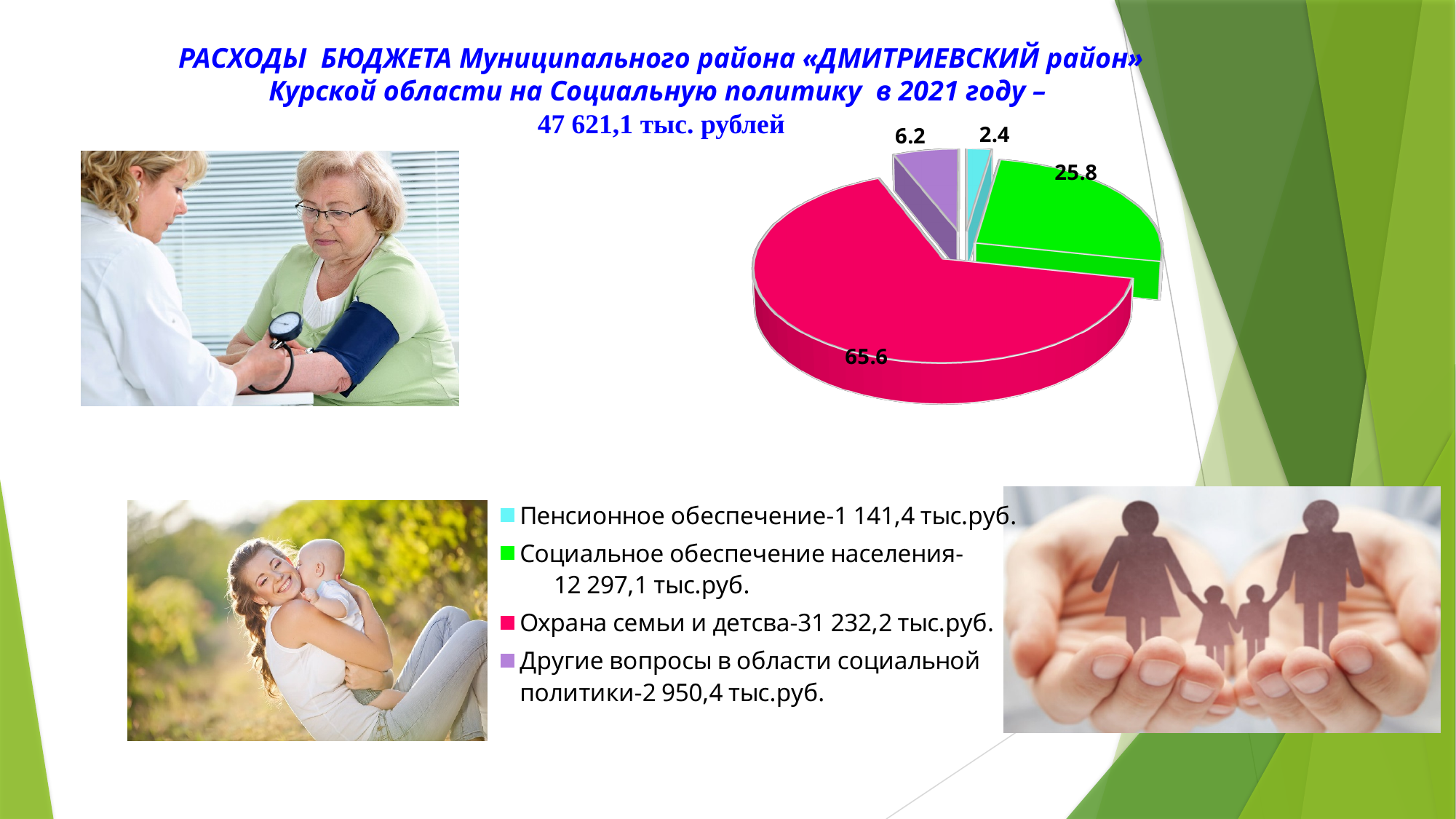
What share of the pie does the slice for Социальное обеспечение населения have? 25.8 What kind of chart is shown on the slide? pie chart What is the difference between the shares for Охрана семьи и детства and Социальное обеспечение населения? 39.8 What share of the pie does the slice for Пенсионное обеспечение have? 2.4 What share of the pie does the slice for Охрана семьи и детства have? 65.6 Which category has the largest slice of the pie? Охрана семьи и детства Which category has the smallest slice of the pie? Пенсионное обеспечение What colour is the slice for Социальное обеспечение населения? green What total amount in thousand rubles is stated in the slide title? 47 621,1 тыс. рублей How many slices does the pie chart have? 4 Which is larger: the slice for Другие вопросы в области социальной политики or the slice for Пенсионное обеспечение? Другие вопросы в области социальной политики